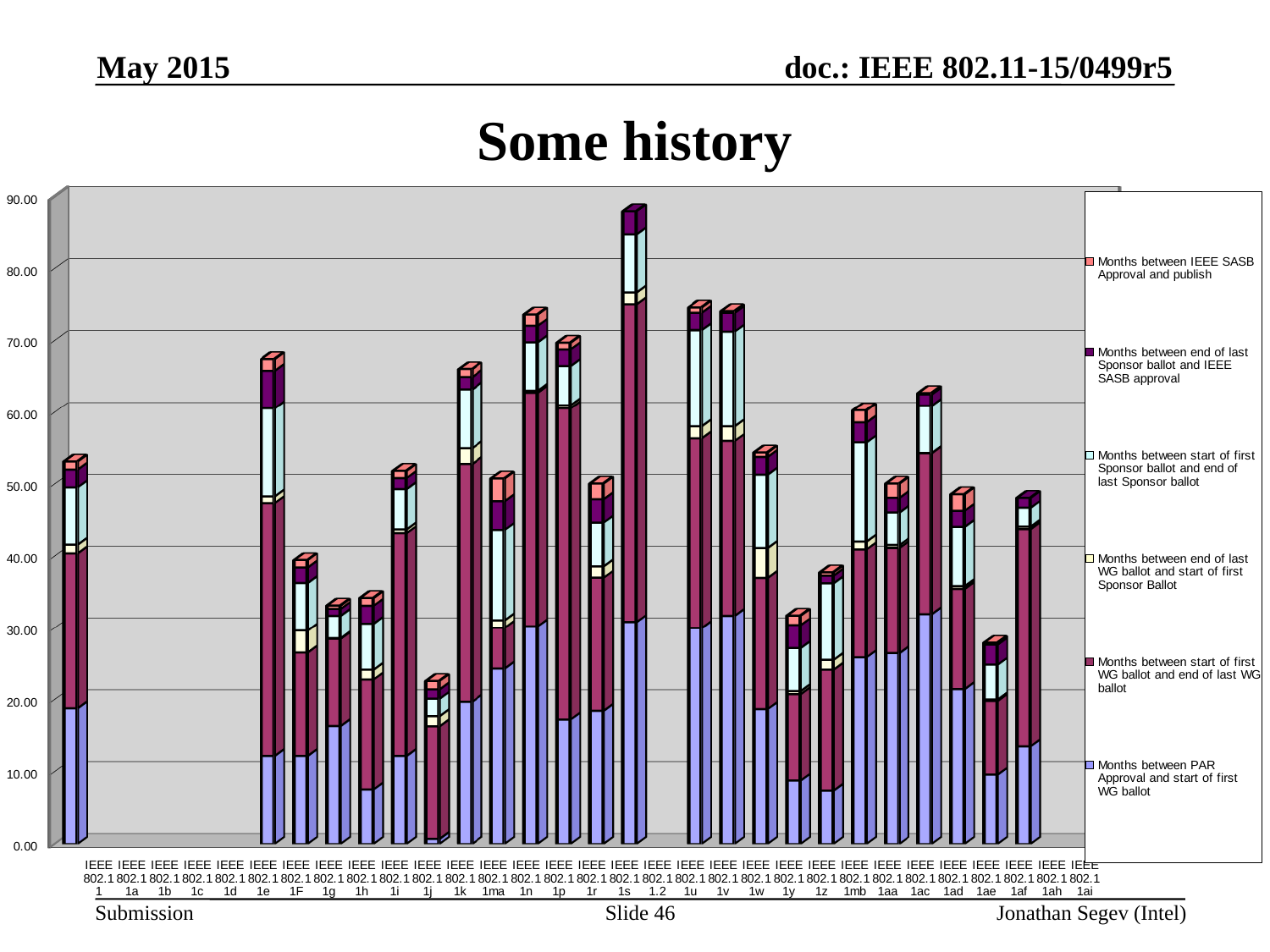
Is the total stacked value for IEEE 802.11g greater or less than 40.00? less Is the total stacked value for IEEE 802.11j greater or less than 30.00? less How many categories are labelled along the x axis? 31 Which category has the tallest stacked bar? IEEE 802.11s What kind of chart is shown on the slide? stacked bar chart How many series does the legend list? 6 Which has the taller stacked bar, IEEE 802.11e or IEEE 802.11g? IEEE 802.11e Which legend entry corresponds to the bottom segment of each stacked bar? Months between PAR Approval and start of first WG ballot Among the categories that have a bar, which has the shortest stacked bar? IEEE 802.11j Is the total stacked value for IEEE 802.11s greater or less than 80.00? greater What is the title of the chart? Some history